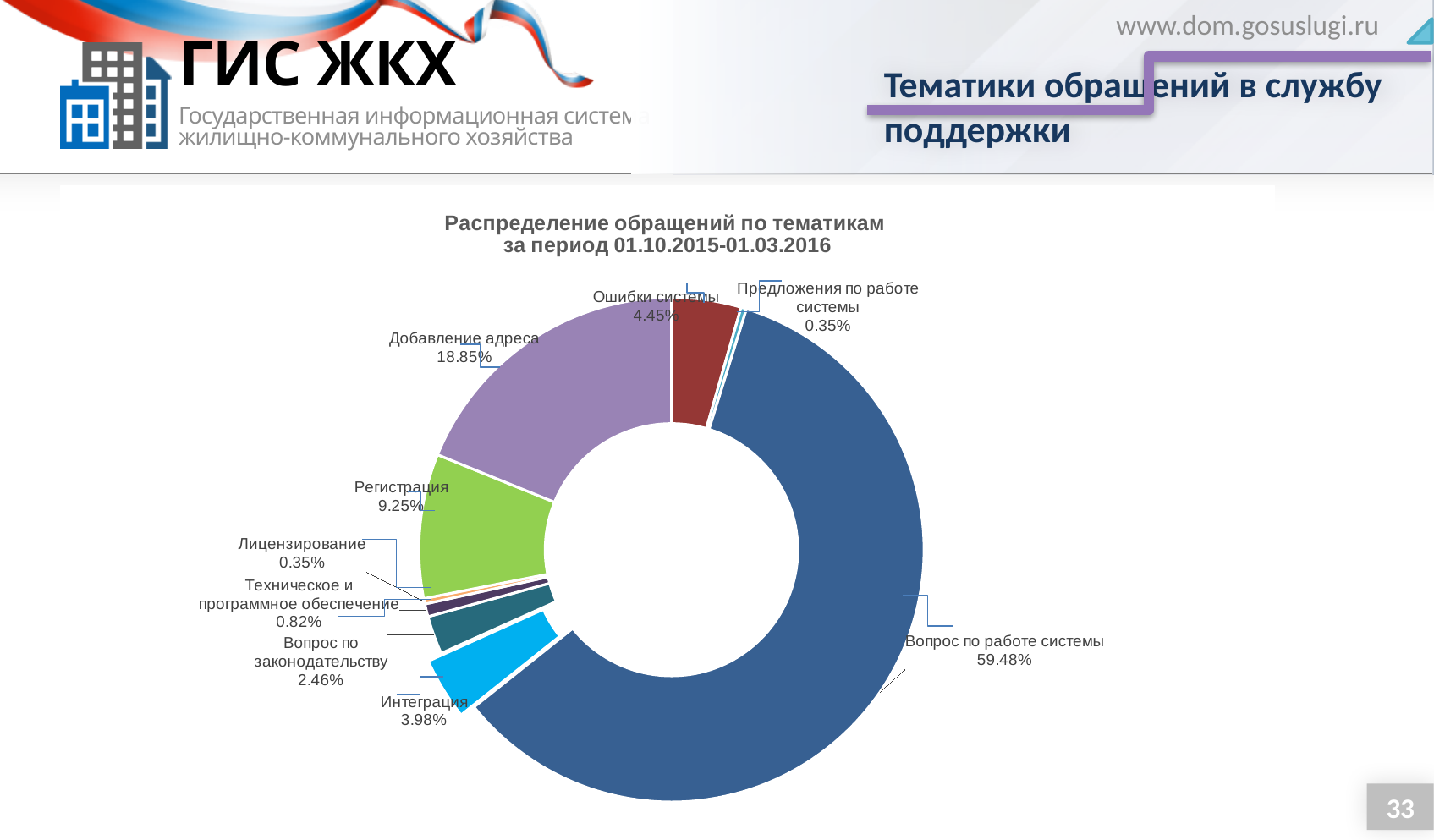
What period does the chart title say the data covers? 01.10.2015-01.03.2016 What share of requests is for "Интеграция"? 3.98% Which topic has a larger share: "Ошибки системы" or "Интеграция"? Ошибки системы What share of requests is for "Техническое и программное обеспечение"? 0.82% What share of requests is for "Регистрация"? 9.25% What is the difference in share between "Добавление адреса" and "Регистрация"? 9.60% Which topic has the largest share of requests? Вопрос по работе системы What share of requests is for "Вопрос по работе системы"? 59.48% What kind of chart is shown on the slide? Doughnut (pie) chart What share of requests is for "Добавление адреса"? 18.85% What share of requests is for "Вопрос по законодательству"? 2.46% How many topic categories are shown in the chart? 9